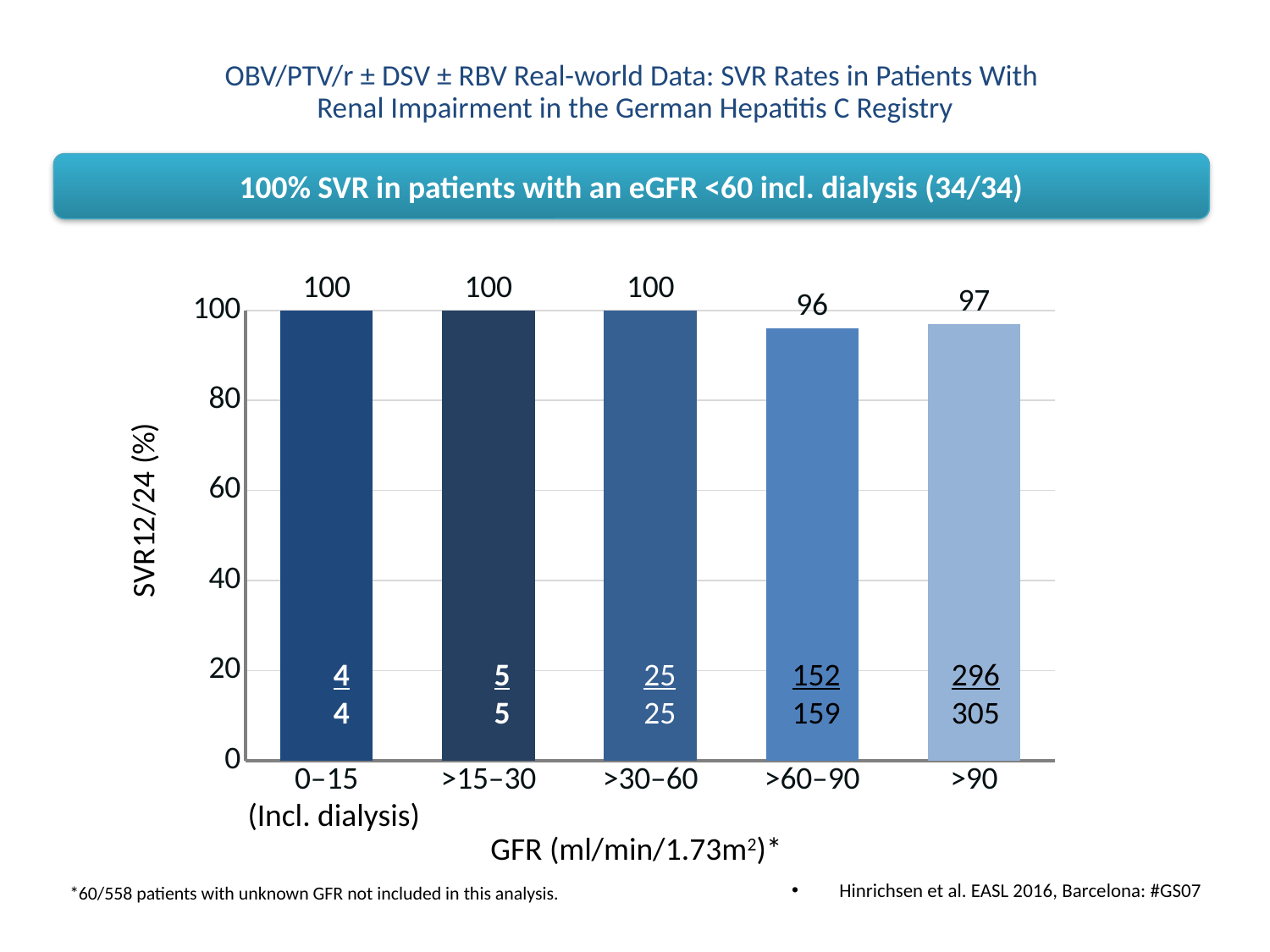
Which has a higher SVR12/24 rate, the >60–90 group or the >90 group? >90 What is the label of the y axis? SVR12/24 (%) What is the difference in SVR12/24 rate between the >30–60 group and the >60–90 group? 4 How many patients achieved SVR in the >60–90 GFR group (numerator shown in the bar)? 152 What kind of chart is shown on the slide? Bar chart How many patients are in the >90 GFR group (denominator shown in the bar)? 305 What is the SVR12/24 rate for the >60–90 GFR group? 96 How many GFR categories are shown on the x axis? 5 Which GFR group has the lowest SVR12/24 rate? >60–90 What is the SVR12/24 rate for the 0–15 (incl. dialysis) GFR group? 100 What is the SVR12/24 rate for the >90 GFR group? 97 Is the SVR12/24 rate for the >60–90 group greater or less than 80? greater